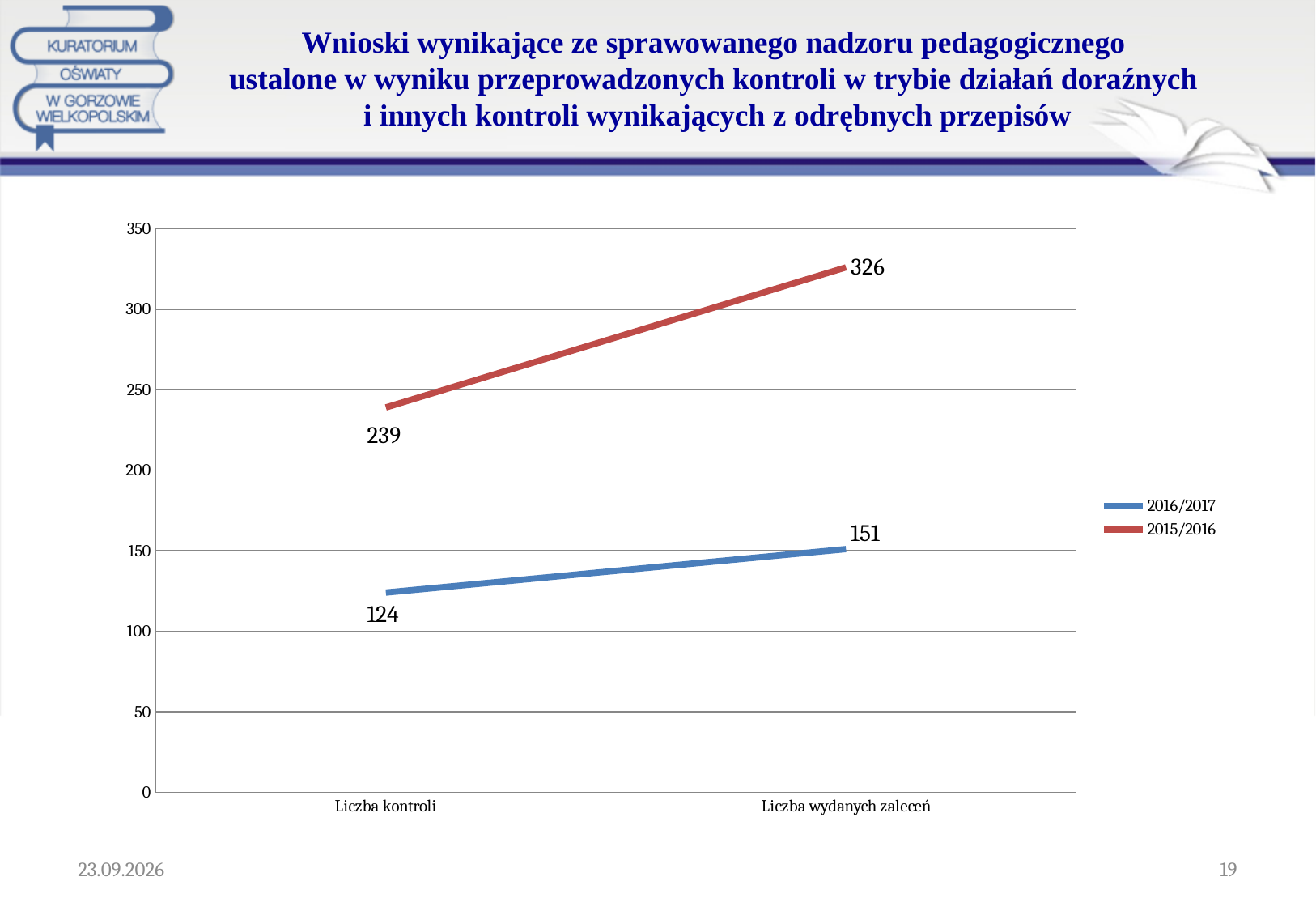
Which category has the highest value in the 2015/2016 series? Liczba wydanych zaleceń Which category has the lowest value in the 2016/2017 series? Liczba kontroli What is the value for Liczba wydanych zaleceń in the 2015/2016 series? 326 What kind of chart is shown on the slide? line chart What is the value for Liczba kontroli in the 2015/2016 series? 239 What is the difference between Liczba wydanych zaleceń and Liczba kontroli in the 2015/2016 series? 87 How many series does the legend list? 2 What is the value for Liczba wydanych zaleceń in the 2016/2017 series? 151 Which series has the larger value for Liczba kontroli, 2016/2017 or 2015/2016? 2015/2016 Do the values of the 2016/2017 series rise or fall from Liczba kontroli to Liczba wydanych zaleceń? rise What is the value for Liczba kontroli in the 2016/2017 series? 124 What is the difference between the 2015/2016 and 2016/2017 values for Liczba wydanych zaleceń? 175